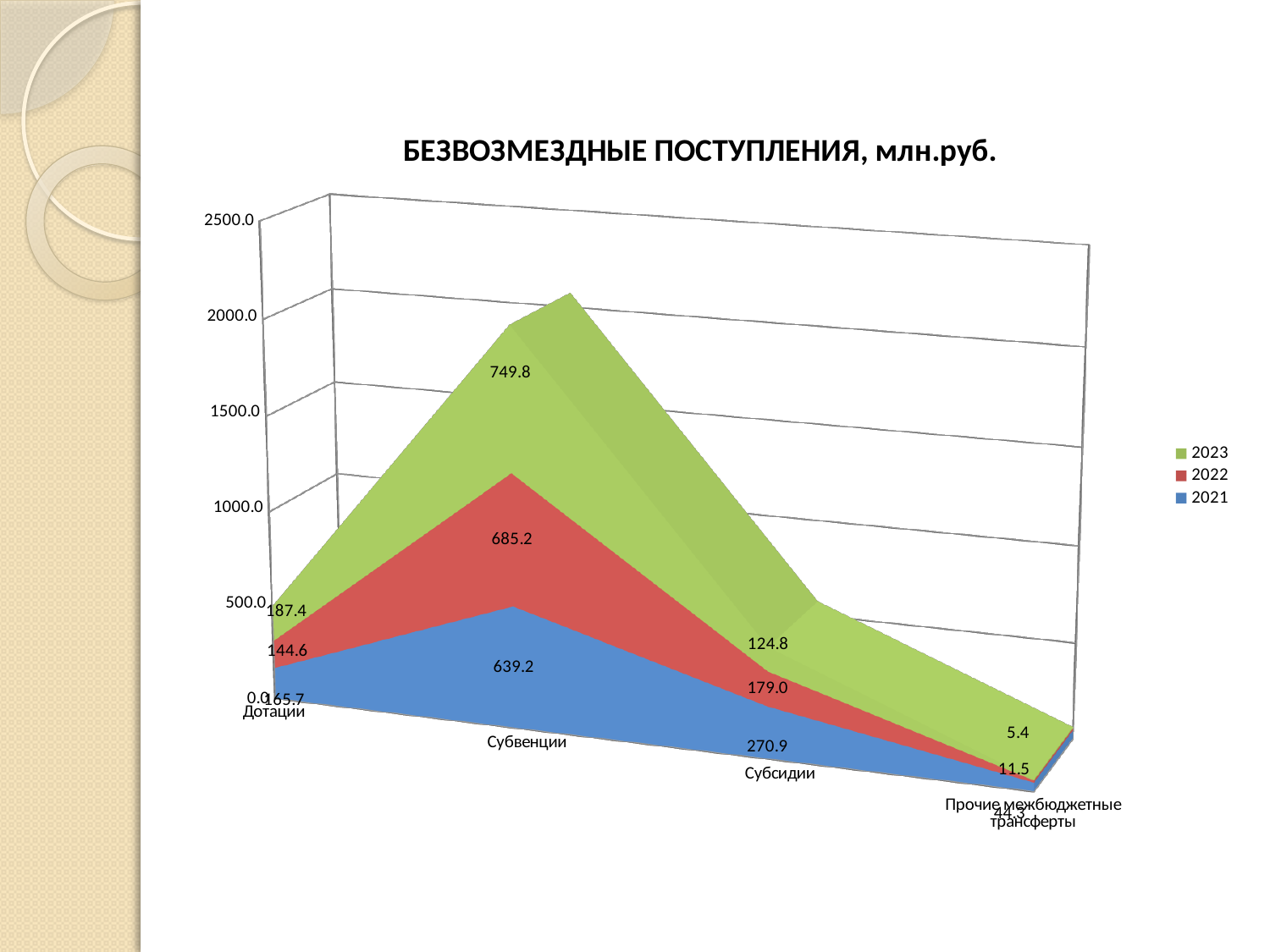
What is the value for Субвенции in the 2021 series? 639.2 What kind of chart is shown on the slide? area chart Which category has the highest value in the 2023 series? Субвенции What is the value for Субвенции in the 2023 series? 749.8 Which category has the lowest value in the 2022 series? Прочие межбюджетные трансферты How many series does the legend list? 3 What is the value for Субсидии in the 2022 series? 179.0 How many categories are shown on the x axis? 4 What is the title of the chart? БЕЗВОЗМЕЗДНЫЕ ПОСТУПЛЕНИЯ, млн.руб. What is the difference between the 2023 and 2022 values for Субвенции? 64.6 What is the value for Дотации in the 2023 series? 187.4 For Субсидии, which series has the larger value, 2021 or 2022? 2021